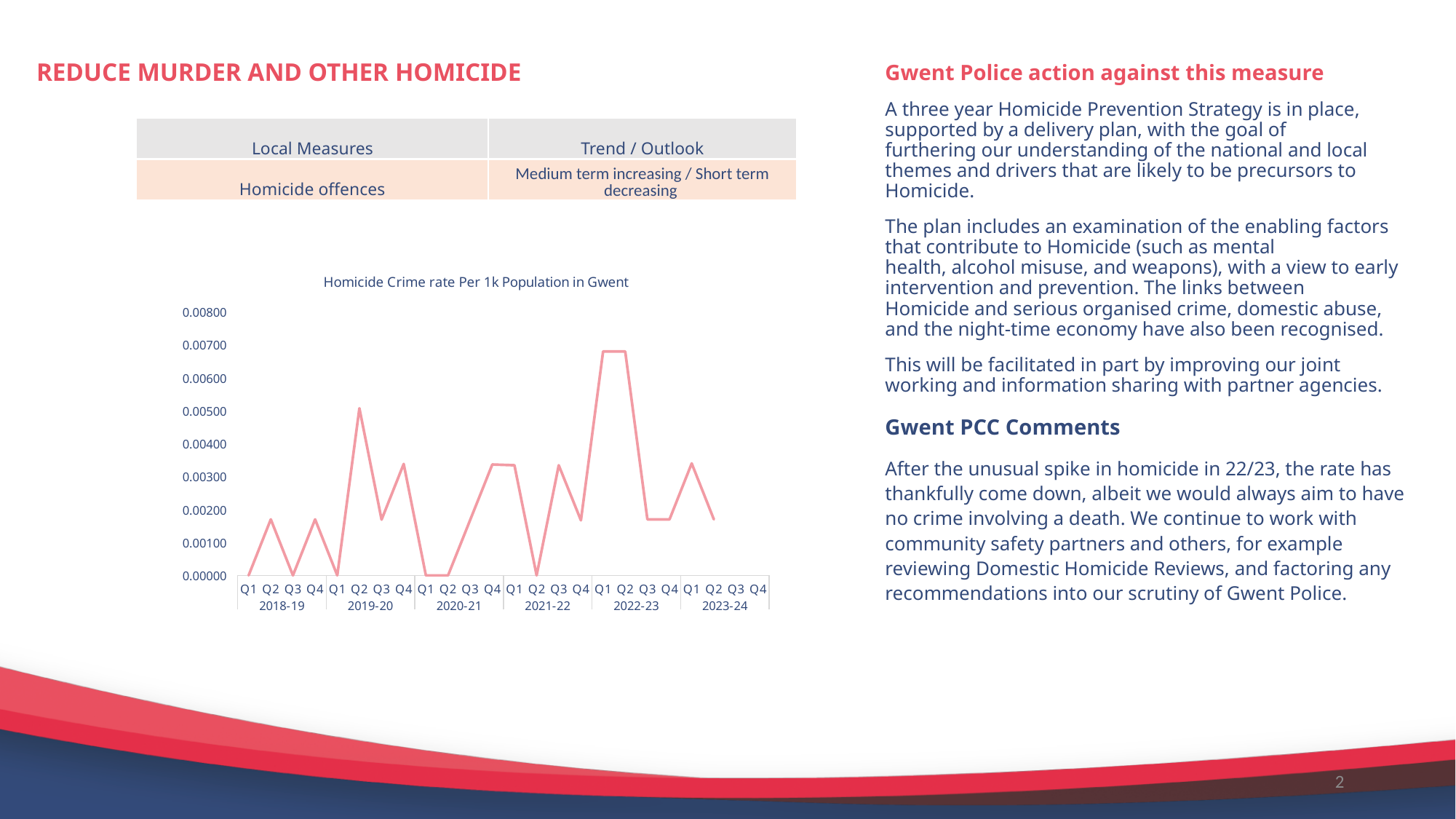
What is the title of the chart? Homicide Crime rate Per 1k Population in Gwent Which is larger, the value for Q2 2019-20 or the value for Q4 2019-20? Q2 2019-20 What kind of chart is shown on the slide? line chart In which financial year does the chart reach its highest peak? 2022-23 Is the value for Q2 2018-19 greater or less than 0.00300? less Does the line rise or fall from Q2 2022-23 to Q3 2022-23? fall What is the value for Q1 2018-19 on the chart? 0.00000 How many financial years are labelled along the x axis of the chart? 6 Is the value for Q1 2022-23 greater or less than 0.00600? greater What is the value for Q1 2020-21 on the chart? 0.00000 Which is larger, the value for Q1 2022-23 or the value for Q1 2023-24? Q1 2022-23 Is the value for Q2 2019-20 greater or less than 0.00400? greater